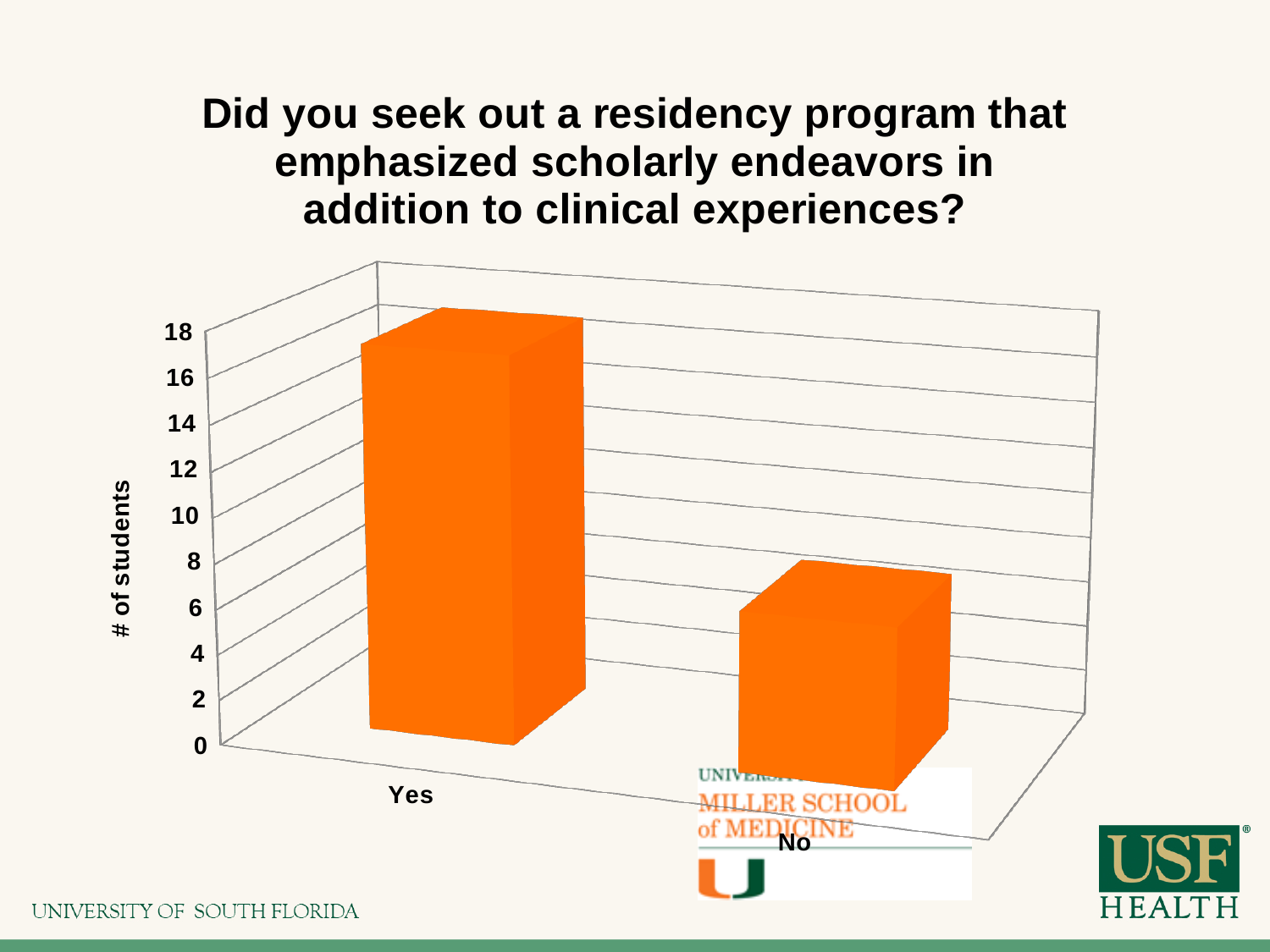
Is the value for Yes greater or less than 10? greater Is the value for No greater or less than 12? less What kind of chart is shown on the slide? bar chart Is the value for Yes greater or less than 14? greater Which category has the lowest number of students? No How many categories are shown on the x axis of the chart? 2 Which category has the highest number of students? Yes What is the highest tick value shown on the vertical axis? 18 What is the label of the vertical axis of the chart? # of students Which is larger, the value for Yes or the value for No? Yes